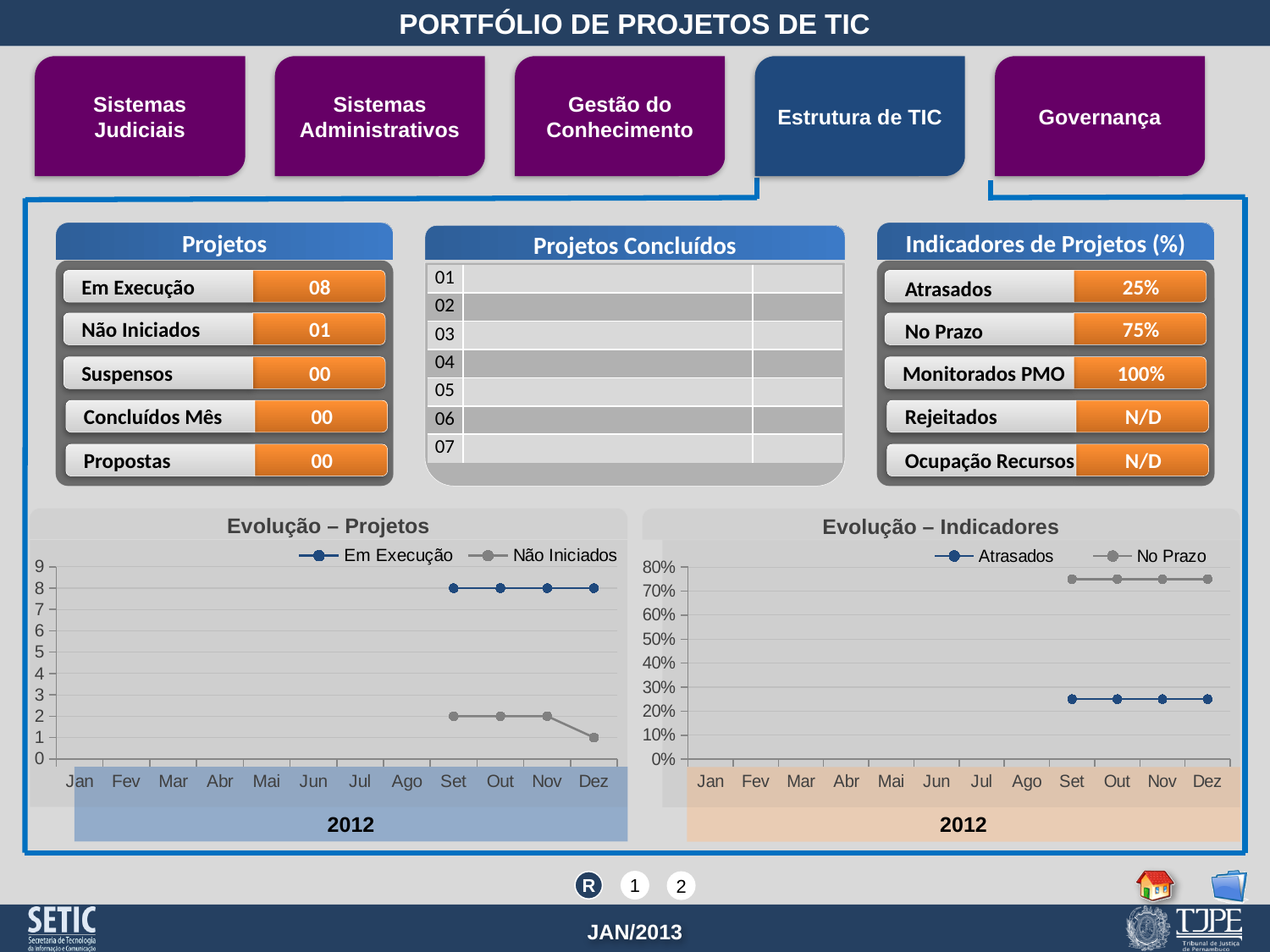
How many months are labelled on the x axis of the 'Evolução – Indicadores' chart? 12 In the 'Evolução – Indicadores' chart, which series is higher in Nov, Atrasados or No Prazo? No Prazo In the 'Evolução – Projetos' chart, what is the value of Em Execução in Dez? 8 In the 'Evolução – Projetos' chart, what is the value of Não Iniciados in Dez? 1 How many series does the legend of the 'Evolução – Projetos' chart list? 2 In the 'Evolução – Projetos' chart, what is the value of Não Iniciados in Set? 2 What kind of chart is 'Evolução – Indicadores'? line chart In the 'Evolução – Projetos' chart, what is the difference between Em Execução and Não Iniciados in Nov? 6 In the 'Evolução – Projetos' chart, which series is higher in Out, Em Execução or Não Iniciados? Em Execução In the 'Evolução – Indicadores' chart, is the value for No Prazo in Dez greater or less than 50%? greater In the 'Evolução – Indicadores' chart, is the value for Atrasados in Set greater or less than 30%? less In the 'Evolução – Projetos' chart, does the Não Iniciados series rise or fall from Nov to Dez? fall